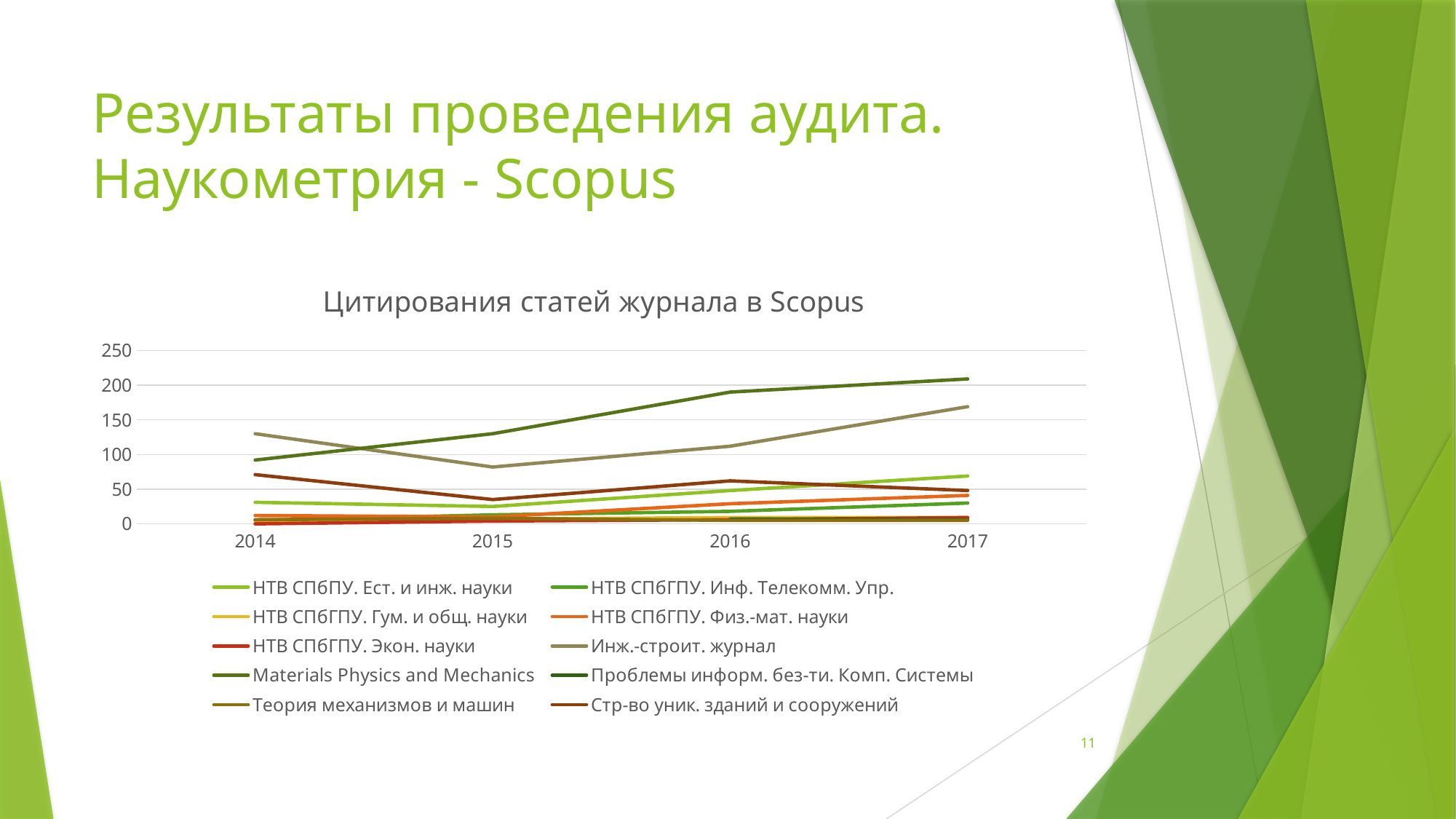
What is the title of the chart? Цитирования статей журнала в Scopus Is the value for Инж.-строит. журнал in 2017 greater or less than 150? greater Which series has the highest value in 2017? Materials Physics and Mechanics Is the value for Инж.-строит. журнал in 2015 greater or less than 100? less Does the line for Materials Physics and Mechanics rise or fall from 2014 to 2017? rise Is the value for Стр-во уник. зданий и сооружений in 2014 greater or less than 50? greater How many years are shown on the x axis of the chart? 4 How many series does the chart legend list? 10 In 2014, which is higher: Инж.-строит. журнал or Materials Physics and Mechanics? Инж.-строит. журнал What kind of chart is shown on the slide? line chart What is the highest value shown on the y axis of the chart? 250